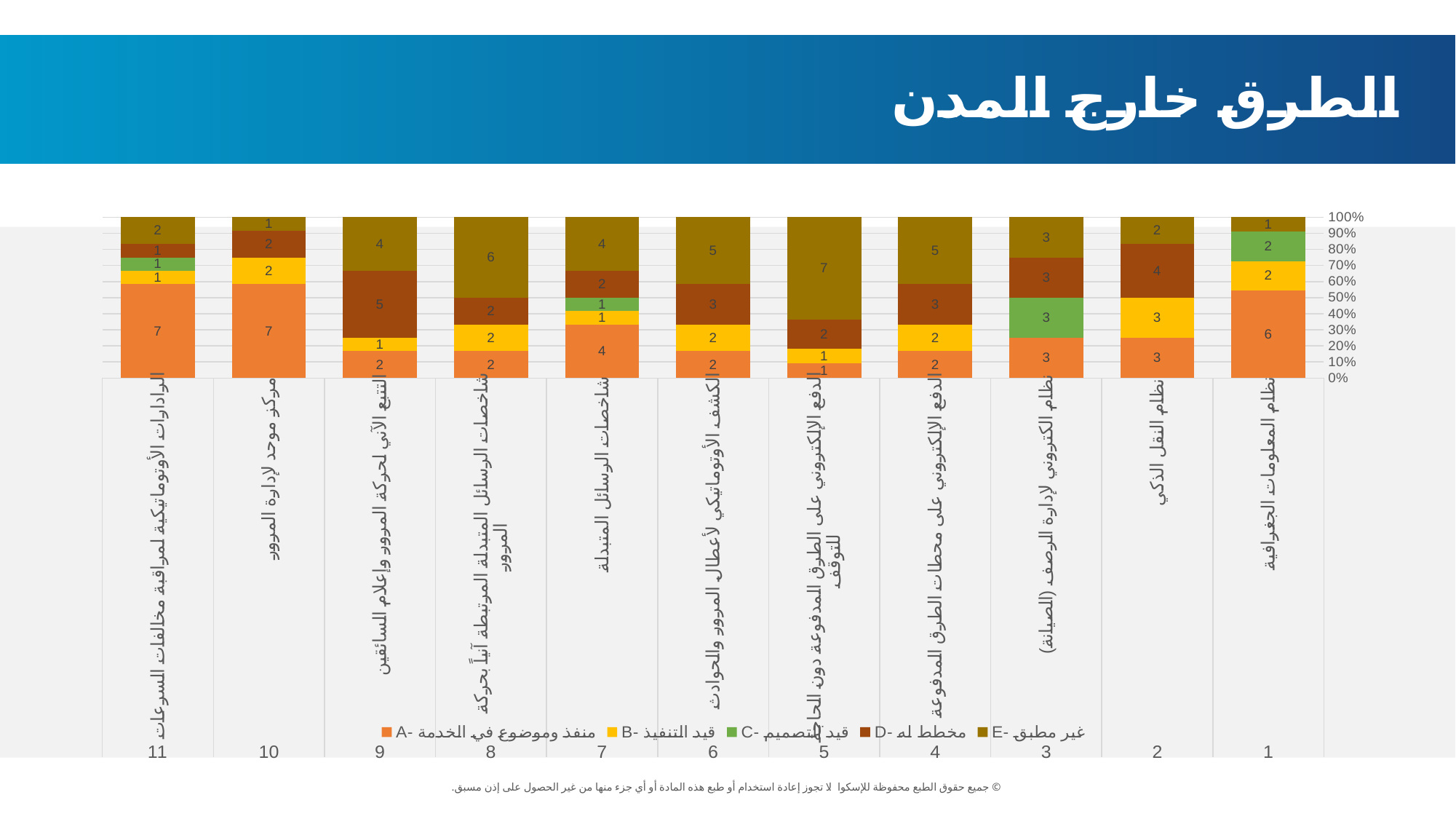
What is the value of series A (منفذ وموضوع في الخدمة) for category 10 (مركز موحد لإدارة المرور)? 7 What is the value of series D (مخطط له) for category 9 (التتبع الآني لحركة المرور وإعلام السائقين)? 5 Which category has the highest value for series E (غير مطبق)? 5 (الدفع الإلكتروني على الطرق المدفوعة دون الحاجة للتوقف) What is the value of series E (غير مطبق) for category 5 (الدفع الإلكتروني على الطرق المدفوعة دون الحاجة للتوقف)? 7 What is the difference between series E for category 8 and series E for category 7? 2 Which is larger: series A for category 1 (نظام المعلومات الجغرافية) or series A for category 2 (نظام النقل الذكي)? Category 1 What is the value of series C (قيد التصميم) for category 3 (نظام الكتروني لإدارة الرصف)? 3 How many series does the legend list? 5 What is the total of all segments in the bar for category 3 (نظام الكتروني لإدارة الرصف)? 12 What kind of chart is shown on the slide? Stacked bar chart What is the title of the slide? الطرق خارج المدن How many categories are plotted along the x axis? 11